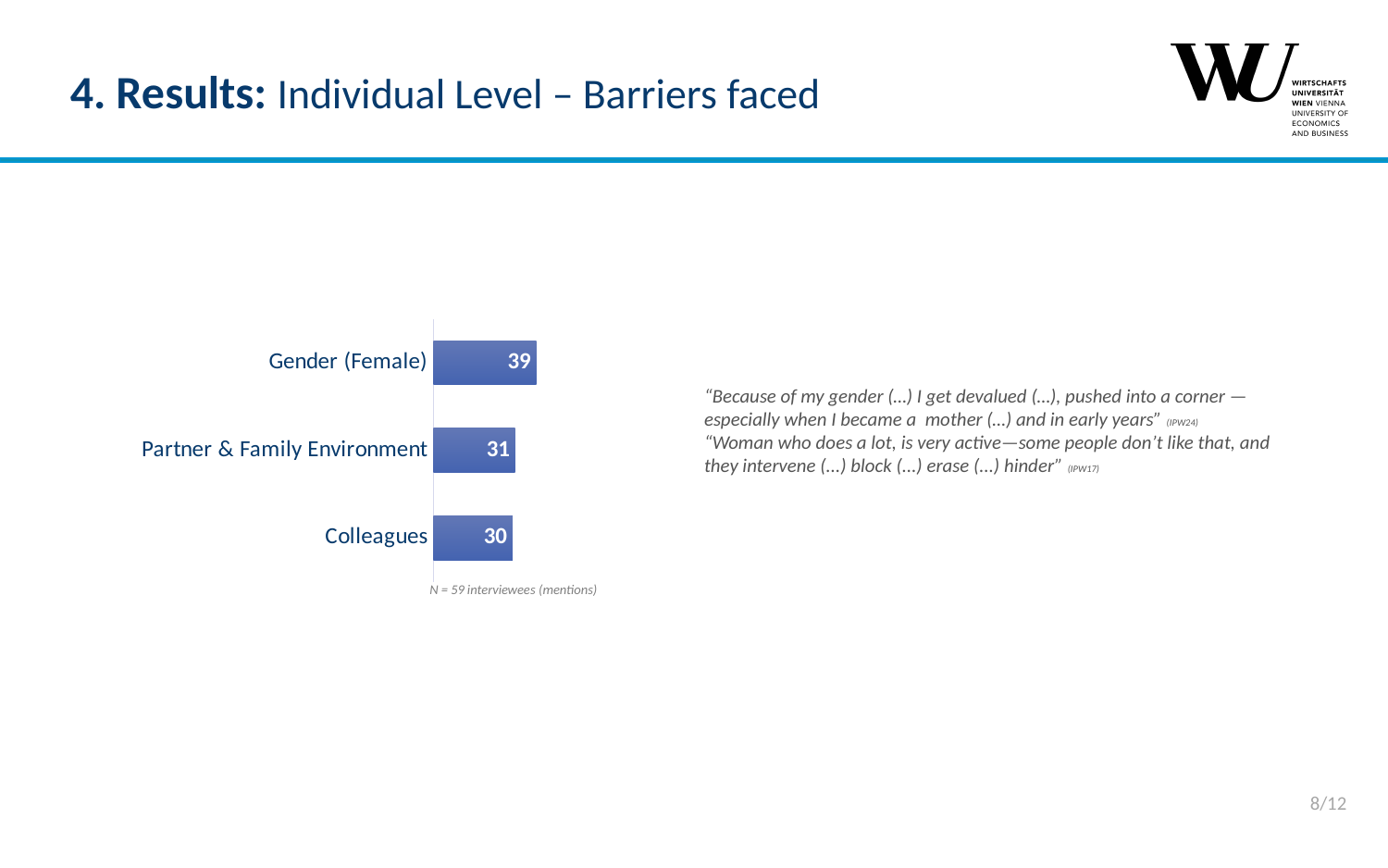
What is the value for Gender (Female)? 39 What is the total of the three values shown in the chart? 100 What is the value for Colleagues? 30 What is the value for Partner & Family Environment? 31 According to the note below the chart, how many interviewees does the chart cover? 59 What is the difference between the values for Partner & Family Environment and Colleagues? 1 How many categories are shown in the chart? 3 Which category has the lowest value? Colleagues Which is larger, the value for Gender (Female) or the value for Partner & Family Environment? Gender (Female) What kind of chart is shown on the slide? bar chart Which category has the highest value? Gender (Female) What is the difference between the values for Gender (Female) and Colleagues? 9